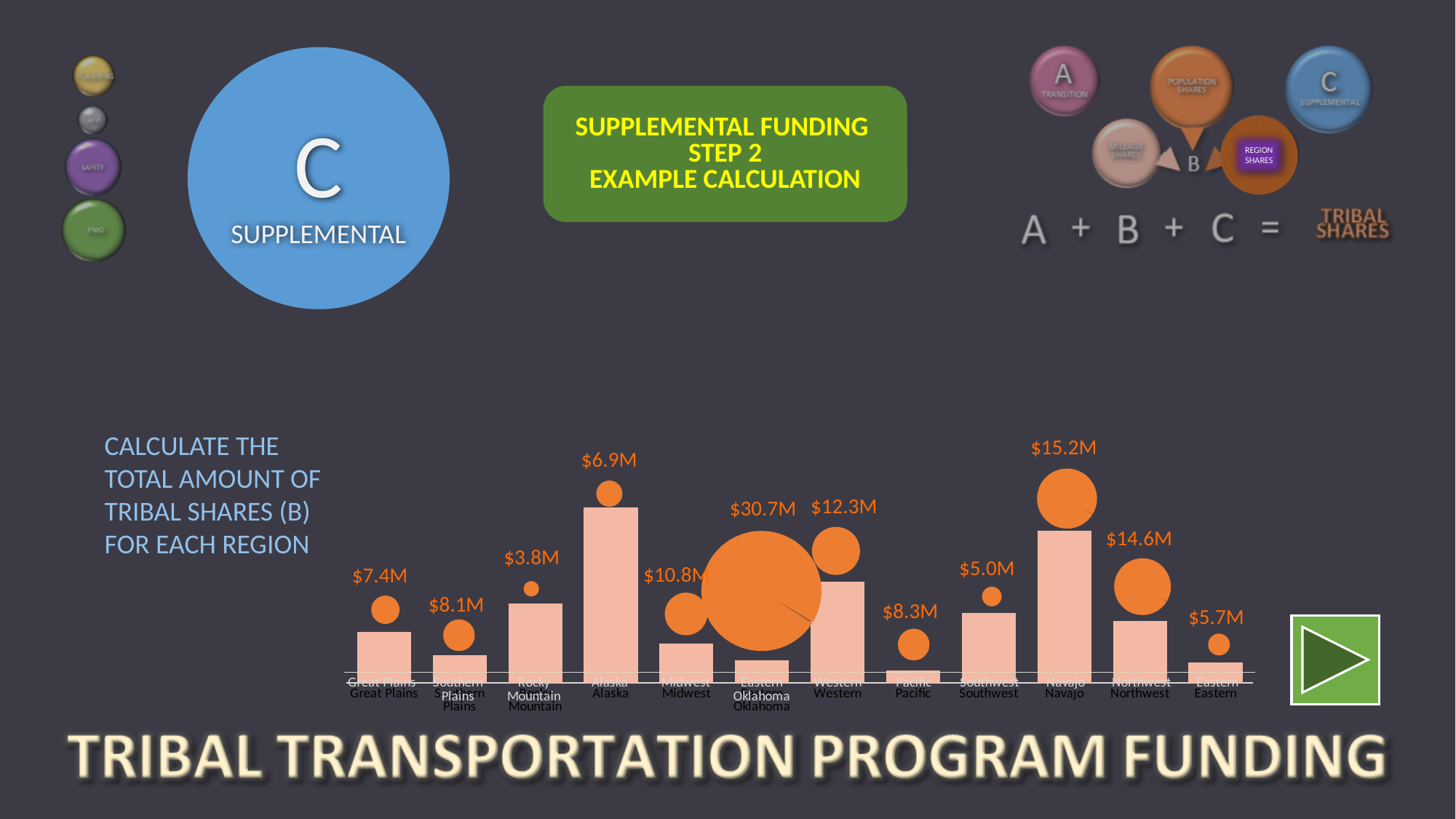
What is the value shown for Southwest? $5.0M How many regions are shown in the chart? 12 Which has the larger value, Pacific or Eastern? Pacific Which region has the highest labelled value? Eastern Oklahoma Which has the larger value, Western or Midwest? Western What is the difference between the values for Navajo and Northwest? $0.6M What kind of chart is shown on the slide? Bar chart What is the difference between the values for Southern Plains and Great Plains? $0.7M What is the value shown for Navajo? $15.2M What is the value shown for Eastern Oklahoma? $30.7M Which region has the lowest labelled value? Rocky Mountain What is the value shown for Rocky Mountain? $3.8M